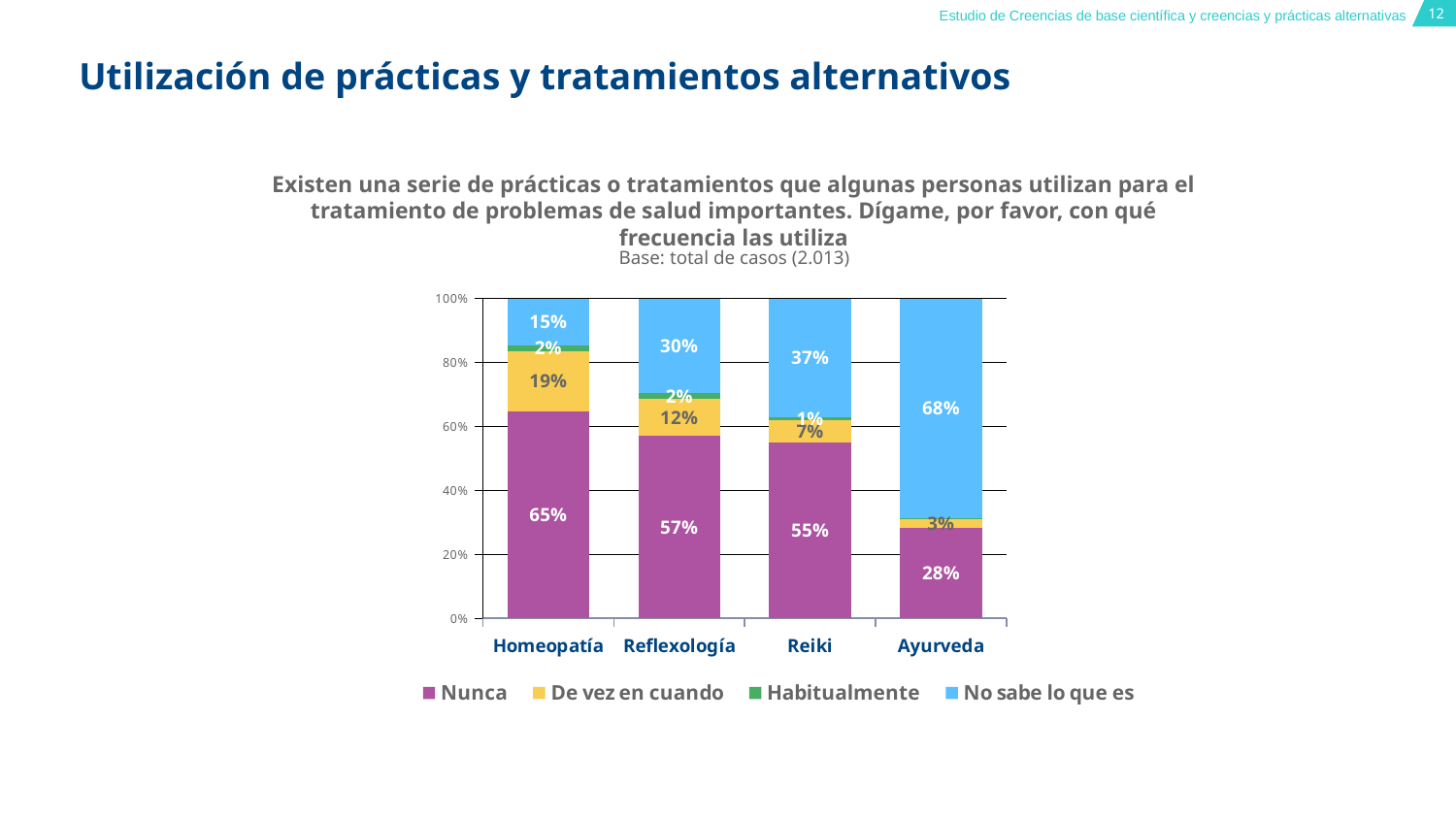
Which practice has the highest "Nunca" value? Homeopatía What is the "Habitualmente" value for Reiki? 1% What is the difference between the "Nunca" values for Homeopatía and Ayurveda? 37% What kind of chart is shown on the slide? Stacked bar chart How many series does the legend list? 4 How many practices are shown on the x axis? 4 Which is larger, the "No sabe lo que es" value for Reiki or for Reflexología? Reiki Which legend entry is shown in blue? No sabe lo que es What is the "De vez en cuando" value for Reflexología? 12% What percentage of respondents answered "Nunca" for Homeopatía? 65% Which practice has the lowest "No sabe lo que es" value? Homeopatía What is the "No sabe lo que es" value for Ayurveda? 68%